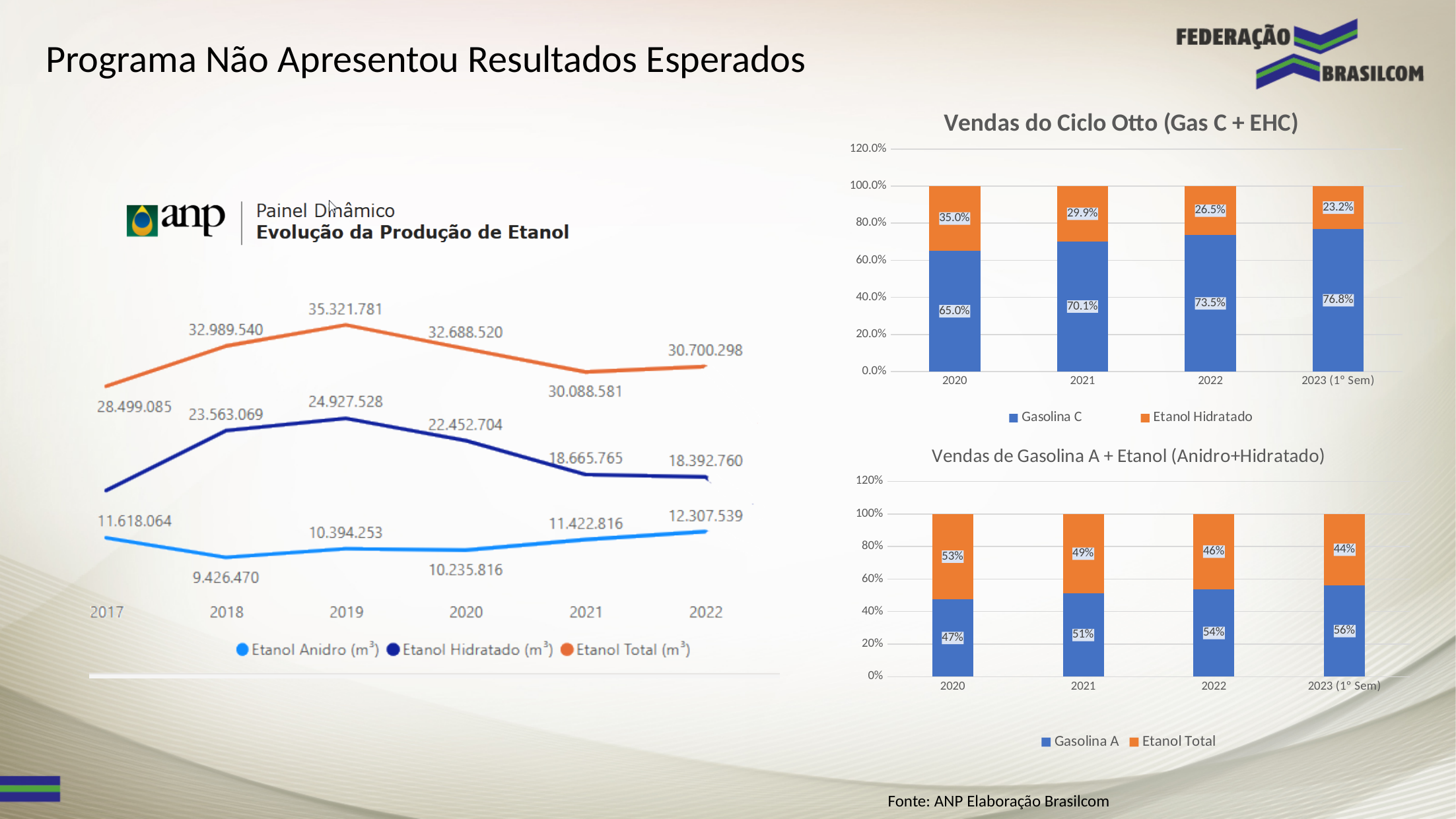
In the 'Evolução da Produção de Etanol' line chart, what is the value of Etanol Total (m³) in 2019? 35.321.781 In the 'Vendas do Ciclo Otto (Gas C + EHC)' chart, what is the value for Etanol Hidratado in 2020? 35.0% In the 'Evolução da Produção de Etanol' line chart, how many years are shown on the x axis? 6 In the 'Vendas do Ciclo Otto (Gas C + EHC)' chart, which year has the lowest Etanol Hidratado share? 2023 (1° Sem) In the 'Vendas de Gasolina A + Etanol (Anidro+Hidratado)' chart, what kind of chart is shown? stacked bar chart In the 'Evolução da Produção de Etanol' line chart, what is the value of Etanol Anidro (m³) in 2018? 9.426.470 In the 'Vendas do Ciclo Otto (Gas C + EHC)' chart, does the Gasolina C share rise or fall from 2020 to 2023 (1° Sem)? rise In the 'Vendas de Gasolina A + Etanol (Anidro+Hidratado)' chart, what is the difference between Etanol Total and Gasolina A in 2020? 6% In the 'Vendas do Ciclo Otto (Gas C + EHC)' chart, what is the value for Gasolina C in 2022? 73.5% In the 'Vendas de Gasolina A + Etanol (Anidro+Hidratado)' chart, how many series does the legend list? 2 In the 'Evolução da Produção de Etanol' line chart, which year has the highest Etanol Hidratado (m³) value? 2019 In the 'Vendas de Gasolina A + Etanol (Anidro+Hidratado)' chart, what is the value for Etanol Total in 2021? 49%